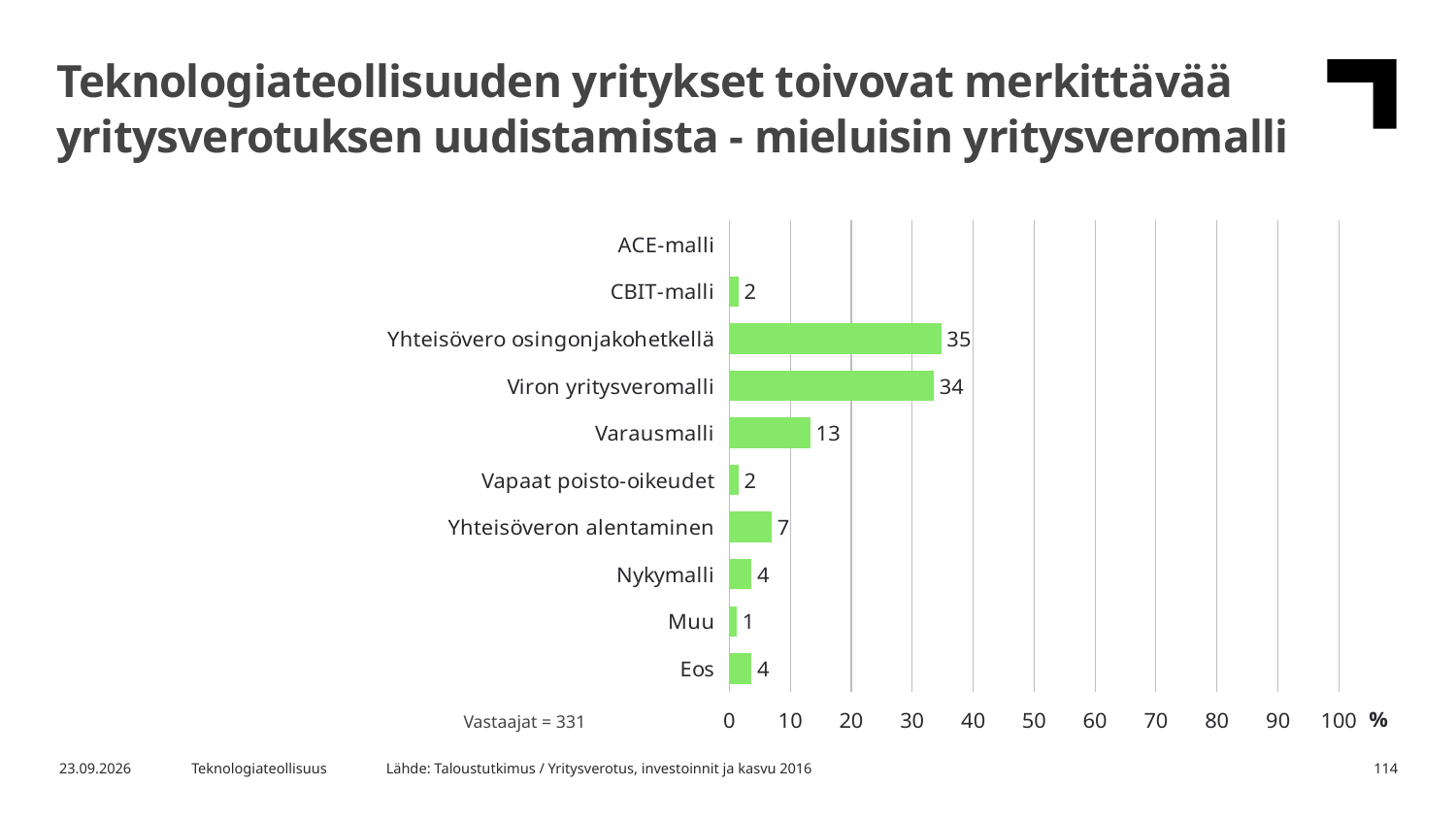
What is the value for Yhteisöveron alentaminen? 7 What kind of chart is shown on the slide? Bar chart What is the value for Yhteisövero osingonjakohetkellä? 35 What is the difference between the values for Yhteisövero osingonjakohetkellä and Viron yritysveromalli? 1 Which category has the highest value? Yhteisövero osingonjakohetkellä How many respondents (Vastaajat) does the chart note? 331 What is the value for Varausmalli? 13 Which is larger, the value for Nykymalli or the value for Muu? Nykymalli What is the difference between the values for Varausmalli and Yhteisöveron alentaminen? 6 What is the value for Viron yritysveromalli? 34 What is the value for Nykymalli? 4 How many categories are shown on the chart? 10